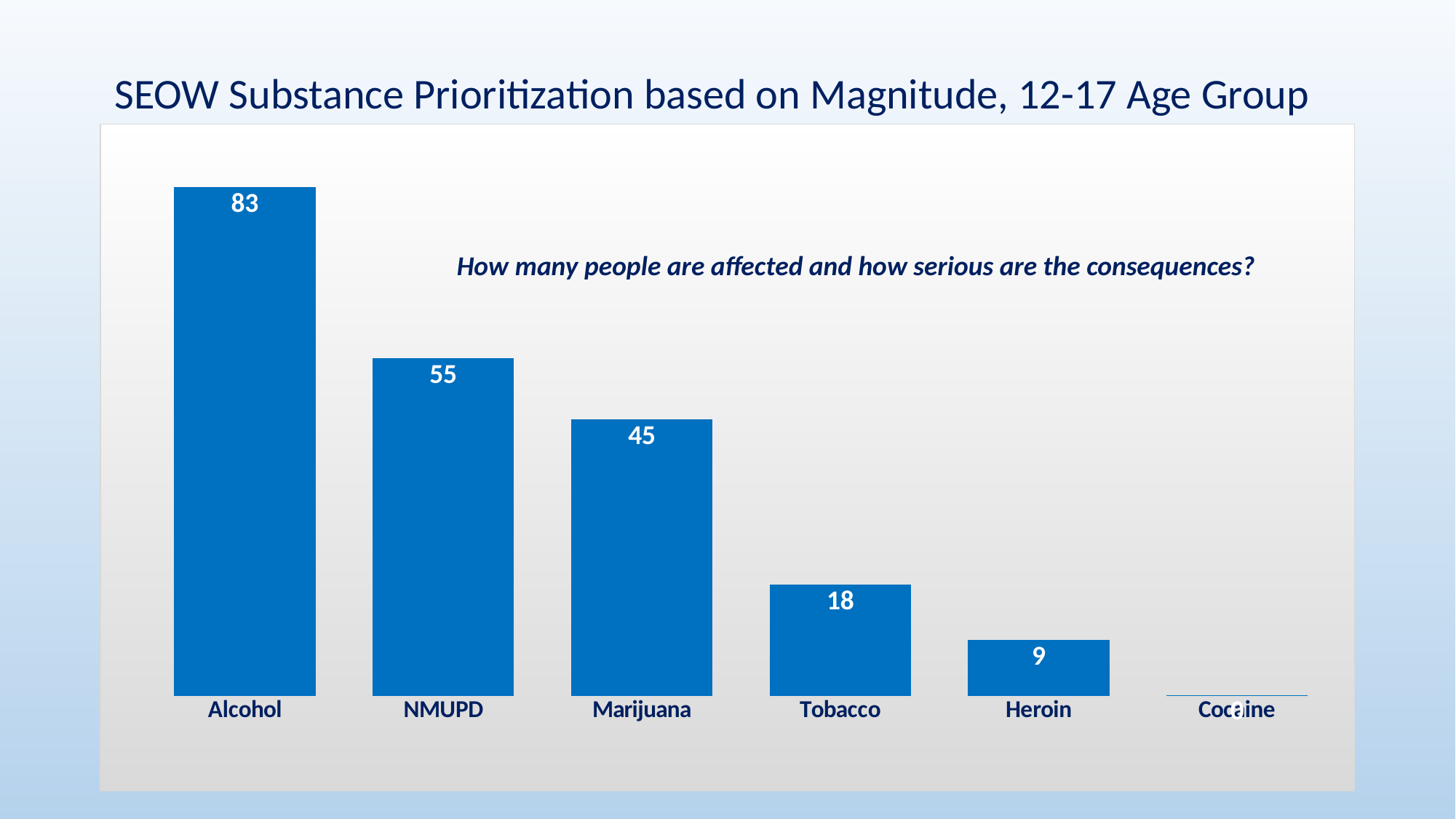
What is the value for Marijuana? 45 What is the value for Tobacco? 18 Which substance has the highest value? Alcohol What is the difference between the values for Tobacco and Heroin? 9 What is the value for NMUPD? 55 What kind of chart is shown on the slide? Bar chart Which substance has the lowest value? Cocaine Which is larger, the value for Marijuana or the value for Tobacco? Marijuana What is the value for Heroin? 9 What is the difference between the values for Alcohol and NMUPD? 28 How many substances are shown on the chart? 6 What is the value for Alcohol? 83